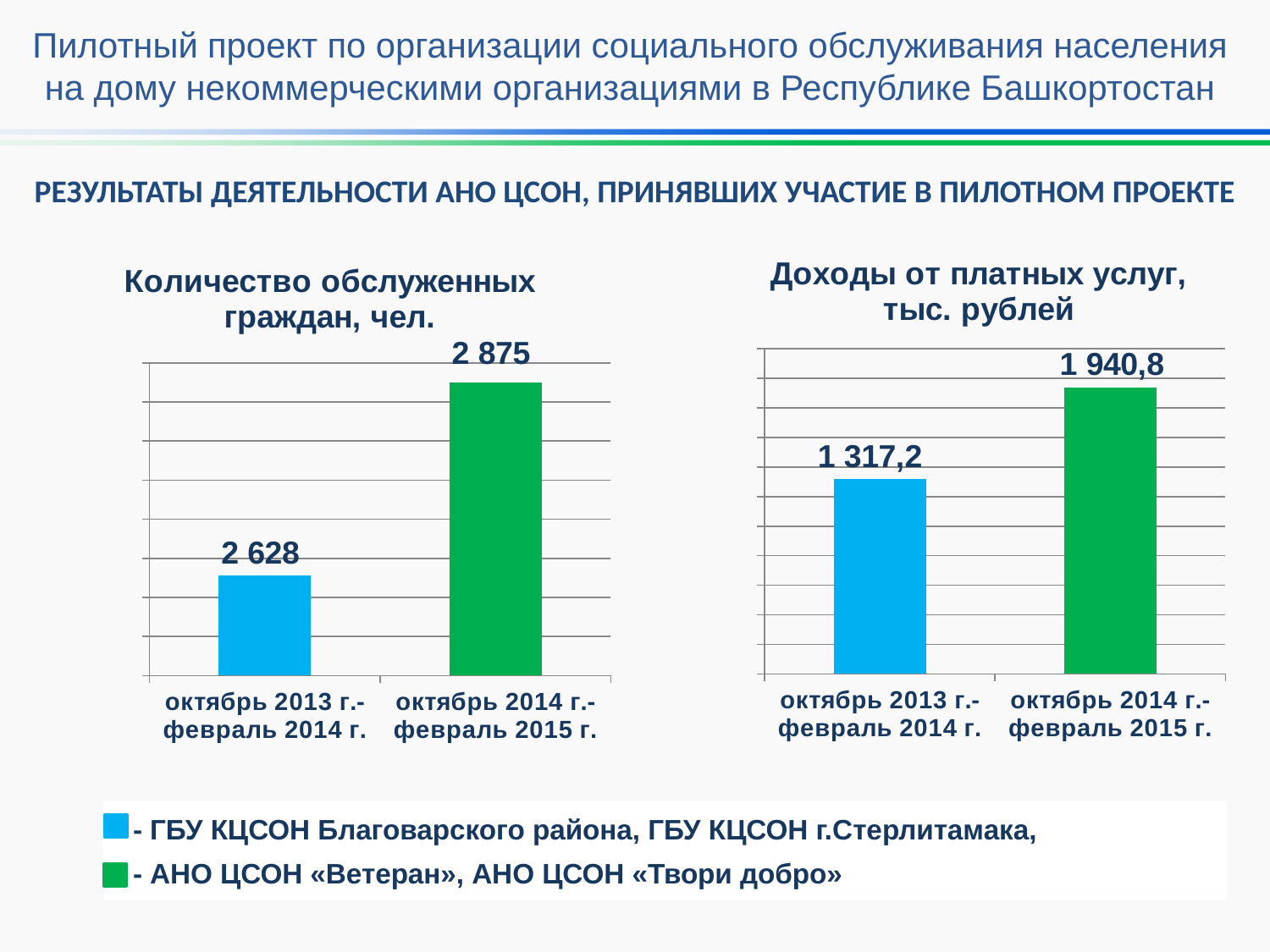
In the chart 'Доходы от платных услуг, тыс. рублей', what is the value for октябрь 2014 г.-февраль 2015 г.? 1 940,8 In the chart 'Доходы от платных услуг, тыс. рублей', what is the value for октябрь 2013 г.-февраль 2014 г.? 1 317,2 In the chart 'Количество обслуженных граждан, чел.', what is the value for октябрь 2014 г.-февраль 2015 г.? 2 875 In the chart 'Количество обслуженных граждан, чел.', do the values rise or fall from the earlier period to the later period? rise How many bars are shown in the chart 'Количество обслуженных граждан, чел.'? 2 In the chart 'Количество обслуженных граждан, чел.', which period has the higher value? октябрь 2014 г.-февраль 2015 г. What type of chart is 'Доходы от платных услуг, тыс. рублей'? bar chart In the chart 'Доходы от платных услуг, тыс. рублей', what is the difference between the values for октябрь 2014 г.-февраль 2015 г. and октябрь 2013 г.-февраль 2014 г.? 623,6 In the chart 'Доходы от платных услуг, тыс. рублей', which period has the lower value? октябрь 2013 г.-февраль 2014 г. In the chart 'Доходы от платных услуг, тыс. рублей', is the value for октябрь 2013 г.-февраль 2014 г. larger or smaller than the value for октябрь 2014 г.-февраль 2015 г.? smaller In the chart 'Количество обслуженных граждан, чел.', what is the value for октябрь 2013 г.-февраль 2014 г.? 2 628 In the chart 'Количество обслуженных граждан, чел.', what is the difference between the values for октябрь 2014 г.-февраль 2015 г. and октябрь 2013 г.-февраль 2014 г.? 247